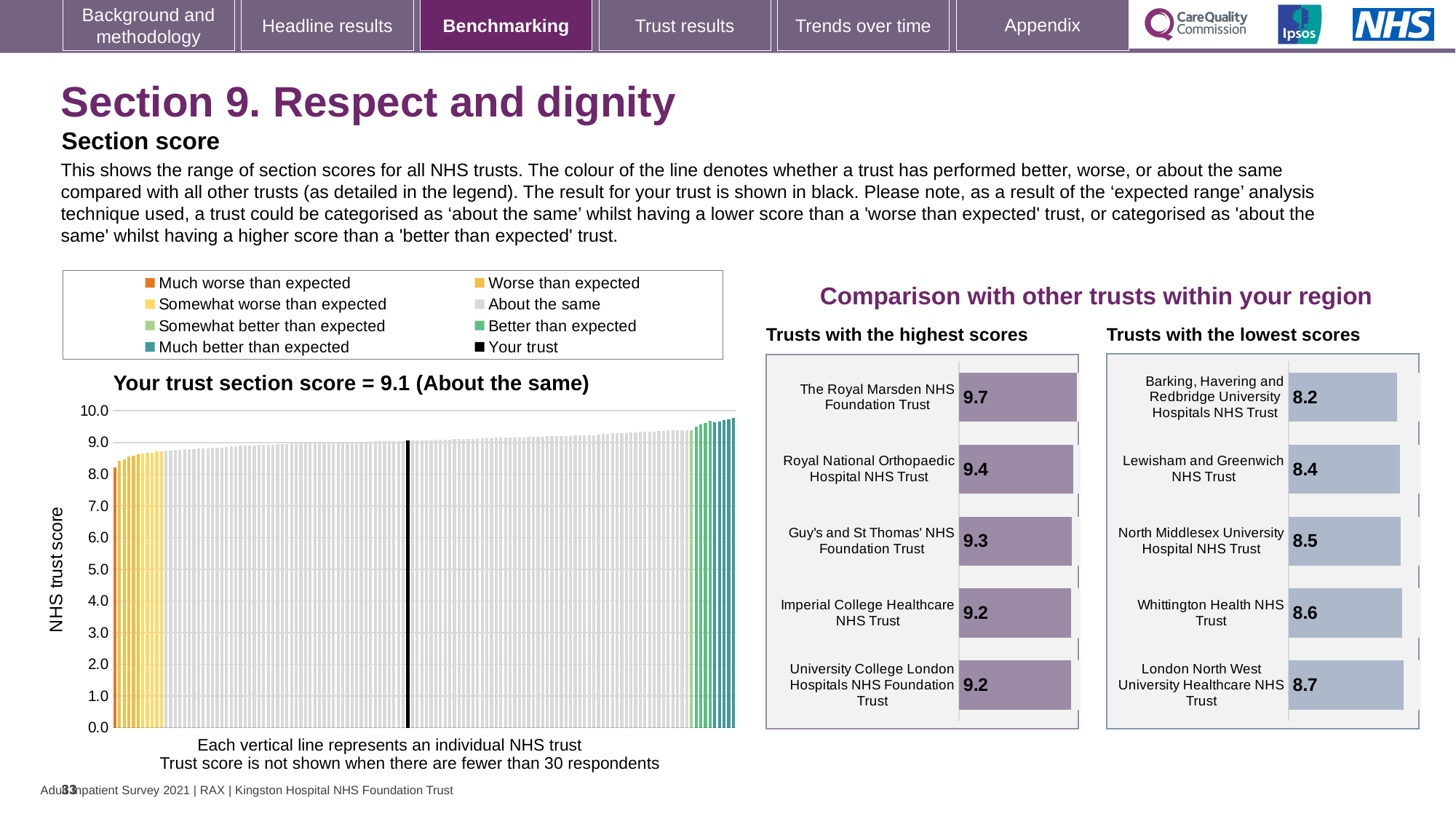
In the 'Trusts with the highest scores' chart, what is the difference between the scores of The Royal Marsden NHS Foundation Trust and Guy's and St Thomas' NHS Foundation Trust? 0.4 In the 'Trusts with the highest scores' chart, what is the score for The Royal Marsden NHS Foundation Trust? 9.7 What kind of chart is the 'Your trust section score' chart on the left? Bar chart How many entries does the legend above the 'Your trust section score' chart list? 8 In the 'Trusts with the lowest scores' chart, which trust has the lowest score? Barking, Havering and Redbridge University Hospitals NHS Trust In the 'Trusts with the highest scores' chart, which trust has the highest score? The Royal Marsden NHS Foundation Trust In the 'Your trust section score' chart on the left, do the values rise or fall from left to right? Rise How many trusts are listed in the 'Trusts with the highest scores' chart? 5 According to the title of the chart on the left, what is your trust's section score? 9.1 In the 'Trusts with the lowest scores' chart, what is the difference between the scores of London North West University Healthcare NHS Trust and Barking, Havering and Redbridge University Hospitals NHS Trust? 0.5 In the 'Trusts with the lowest scores' chart, which has the higher score: North Middlesex University Hospital NHS Trust or Whittington Health NHS Trust? Whittington Health NHS Trust In the 'Trusts with the lowest scores' chart, what is the score for Lewisham and Greenwich NHS Trust? 8.4